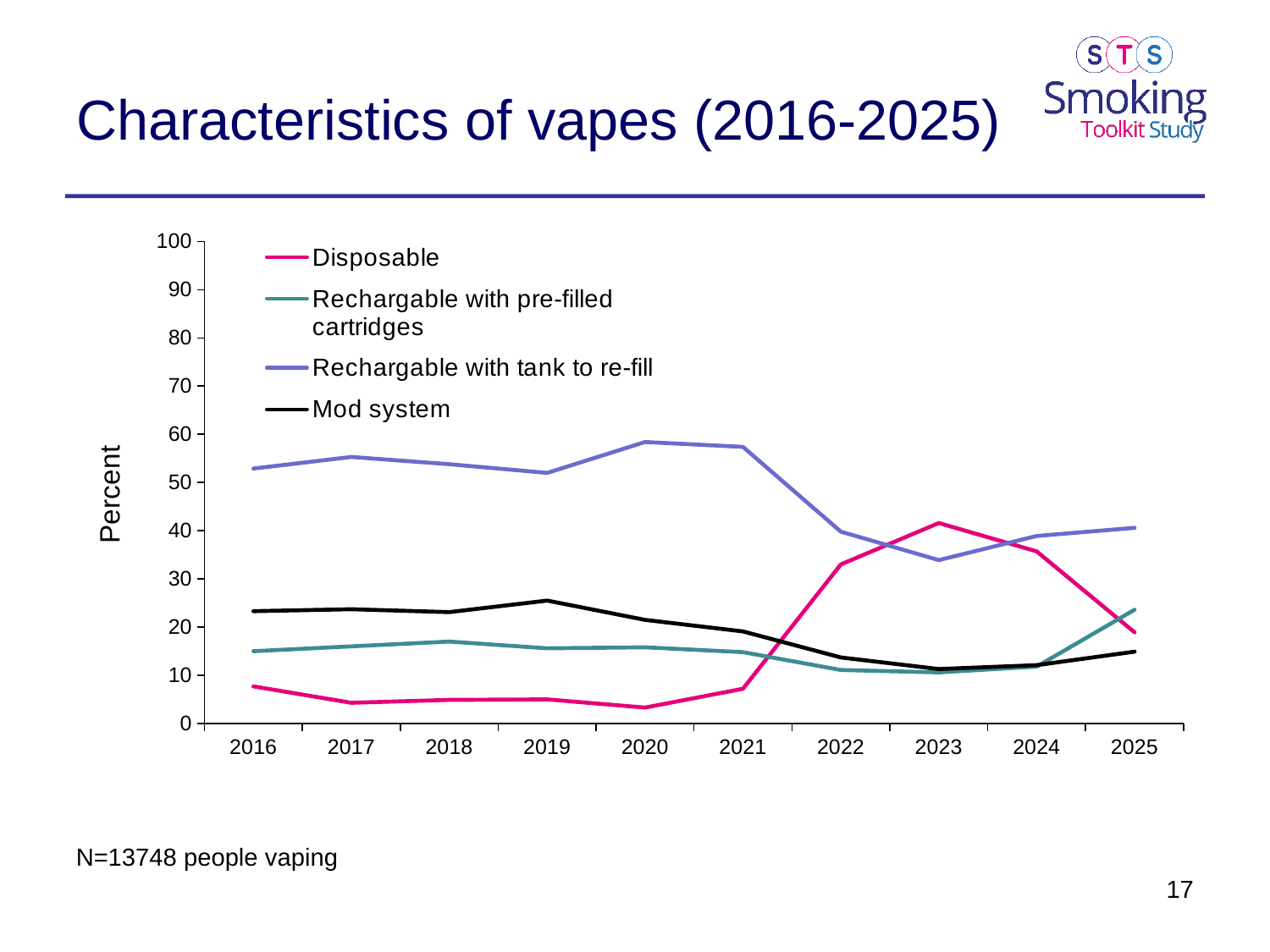
In which year does the Disposable line reach its highest value? 2023 How many years are shown along the x axis? 10 How many series does the legend list? 4 What kind of chart is shown on the slide? Line chart Does the Mod system line rise or fall from 2019 to 2023? Fall What colour is the Disposable line? Pink Is the value for Disposable in 2016 greater or less than 10? less What is the label on the y axis? Percent Which series has the highest value in 2016? Rechargable with tank to re-fill In 2023, which is larger: Disposable or Rechargable with tank to re-fill? Disposable Is the value for Rechargable with tank to re-fill in 2020 greater or less than 50? greater Which series has the lowest value in 2020? Disposable